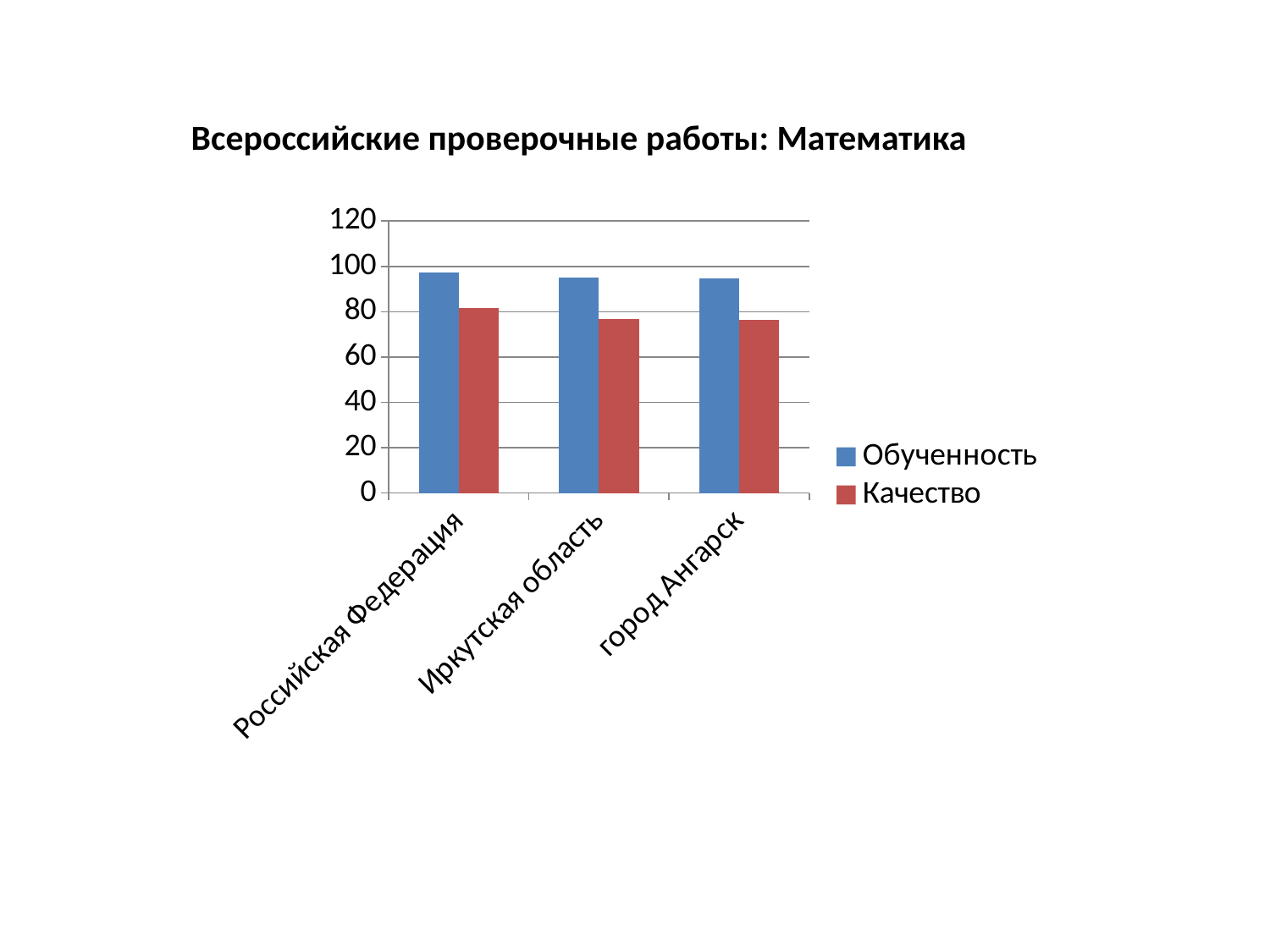
Is the value of Обученность for Российская Федерация greater or less than 80? greater Is the value of Обученность for город Ангарск greater or less than 100? less What is the title of the chart? Всероссийские проверочные работы: Математика Do the values of Качество rise or fall from Российская Федерация to город Ангарск? fall How many series does the legend list? 2 Which category has the highest value for Качество? Российская Федерация For Российская Федерация, which is larger: Обученность or Качество? Обученность What kind of chart is shown on the slide? bar chart Is the value of Качество for Иркутская область greater or less than 80? less How many categories are shown on the x axis? 3 For город Ангарск, which is larger: Обученность or Качество? Обученность Which series is shown in red? Качество